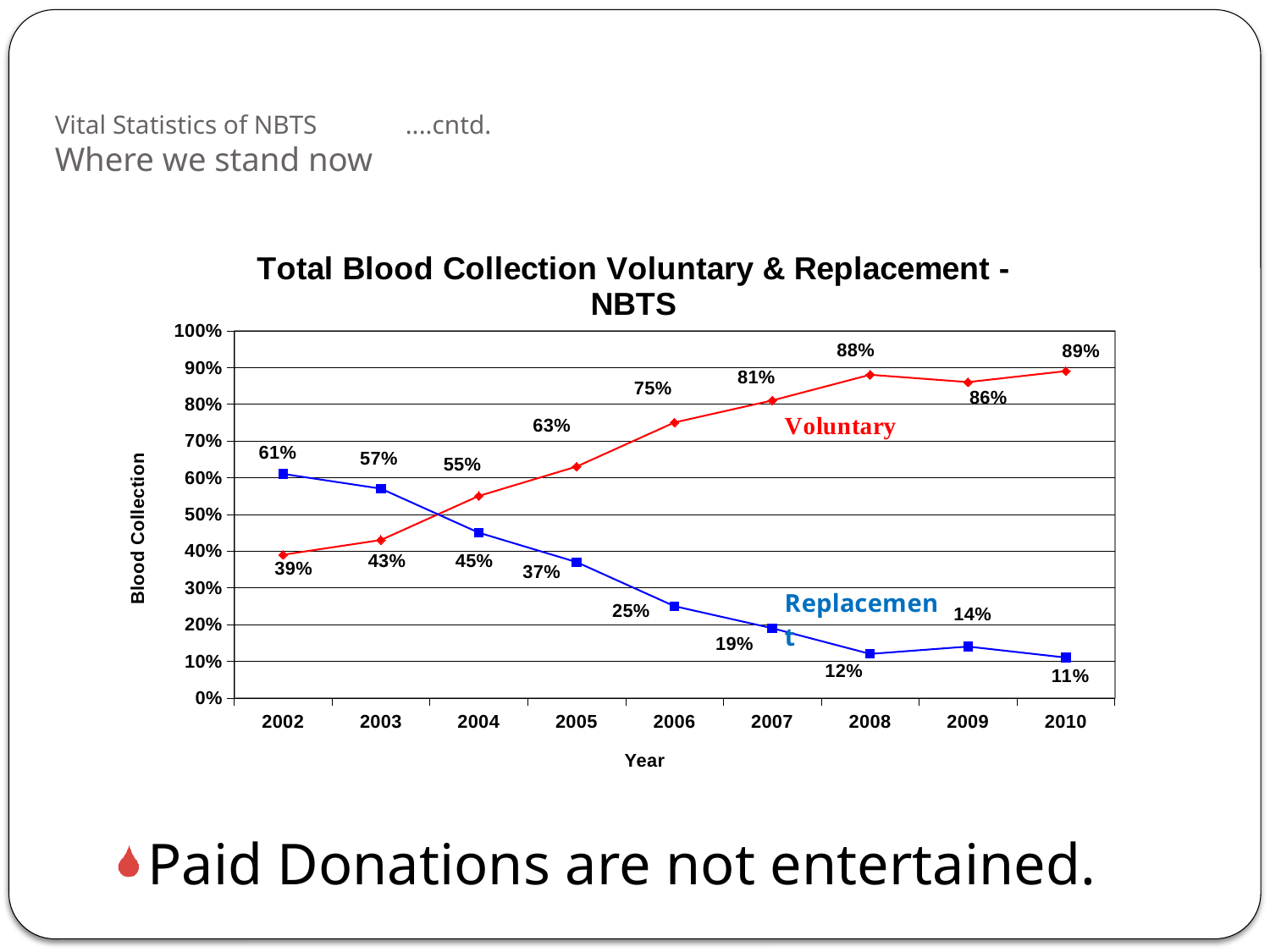
What is the Replacement value for 2008? 12% What type of chart is shown on the slide? line chart Does the Replacement series rise or fall from 2002 to 2010? fall What is the Voluntary value for 2006? 75% What is the difference between the Voluntary and Replacement values in 2005? 26% What is the Replacement value for 2002? 61% In which year is the Replacement value lowest? 2010 In which year is the Voluntary value highest? 2010 Which is larger in 2003, the Voluntary value or the Replacement value? Replacement What is the Voluntary value for 2010? 89% How many years are plotted on the x axis? 9 How many series are plotted on the chart? 2